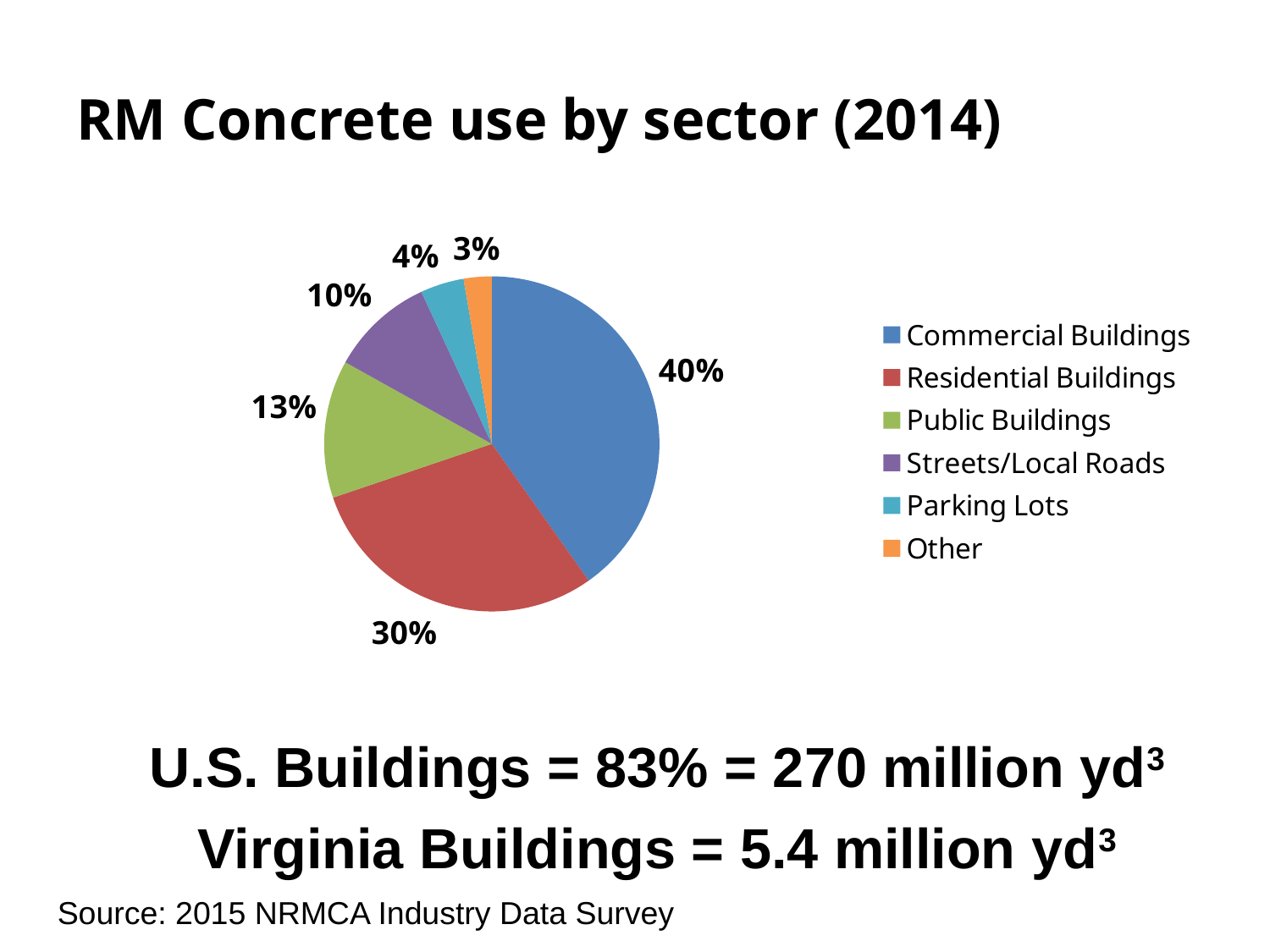
What share of RM concrete use does Parking Lots account for? 4% Which sector has the largest share of RM concrete use? Commercial Buildings What share of RM concrete use does Commercial Buildings account for? 40% What share of RM concrete use does Residential Buildings account for? 30% How many sectors are shown in the pie chart? 6 Which has a larger share, Public Buildings or Streets/Local Roads? Public Buildings What is the difference in share between Commercial Buildings and Residential Buildings? 10% What is the title of the chart? RM Concrete use by sector (2014) What type of chart is shown on the slide? Pie chart What share of RM concrete use does Streets/Local Roads account for? 10% What share of RM concrete use does Public Buildings account for? 13% Which sector has the smallest share of RM concrete use? Other